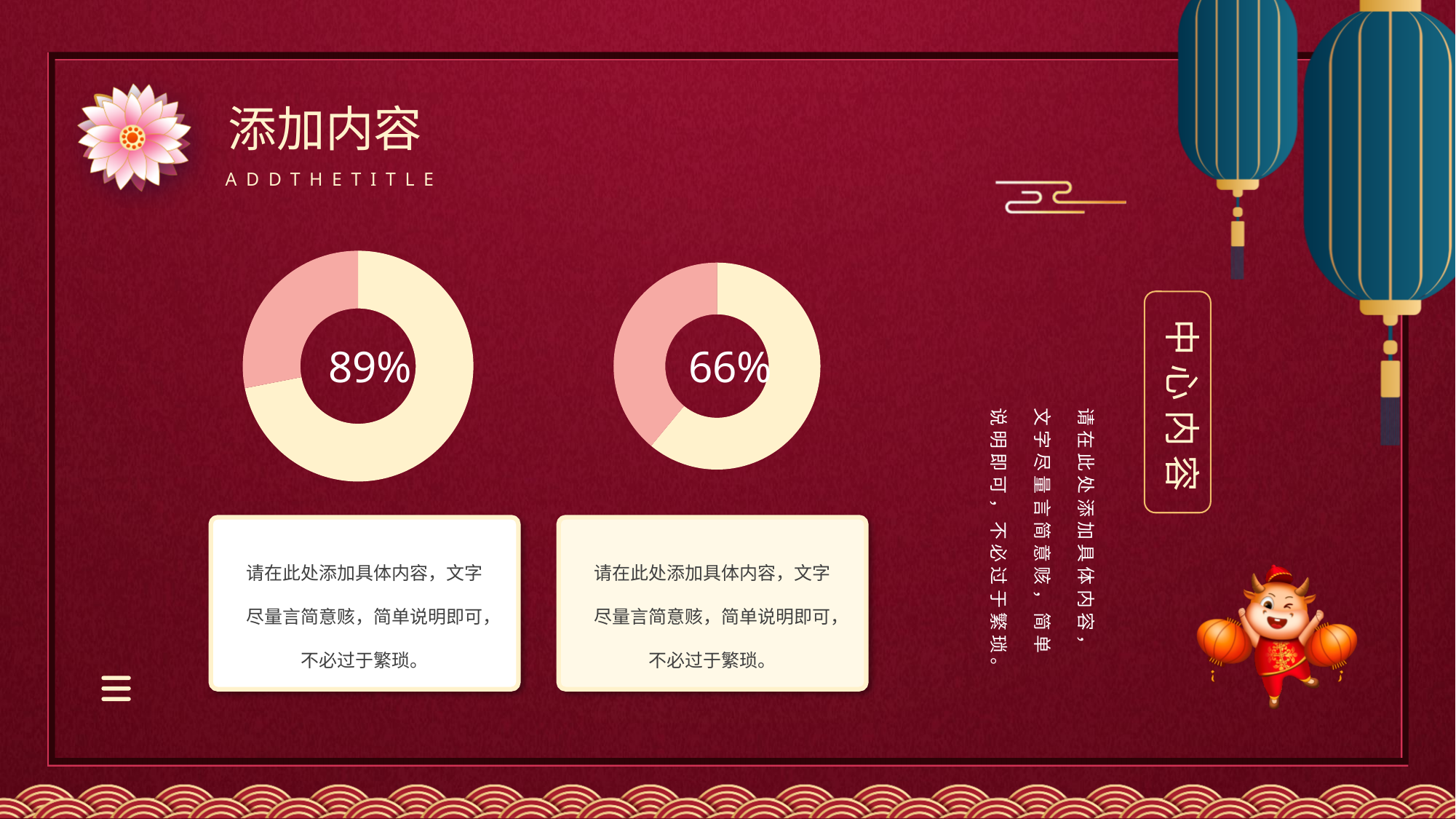
What percentage is shown in the centre of the left donut chart? 89% Which donut chart shows the larger percentage, the left one or the right one? The left one What percentage is shown in the centre of the right donut chart? 66% What two colours are used for the slices of the donut charts? Cream (pale yellow) and pink What kind of chart is used on the right side of the slide? Donut chart How many slices does the left donut chart have? 2 What kind of chart is used on the left side of the slide? Donut chart Is the percentage shown in the right donut chart greater or less than 50%? greater What is the difference between the percentage in the left donut chart and the percentage in the right donut chart? 23 percentage points How many donut charts are on the slide? 2 Which donut chart shows the smaller percentage, the left one or the right one? The right one How many slices does the right donut chart have? 2